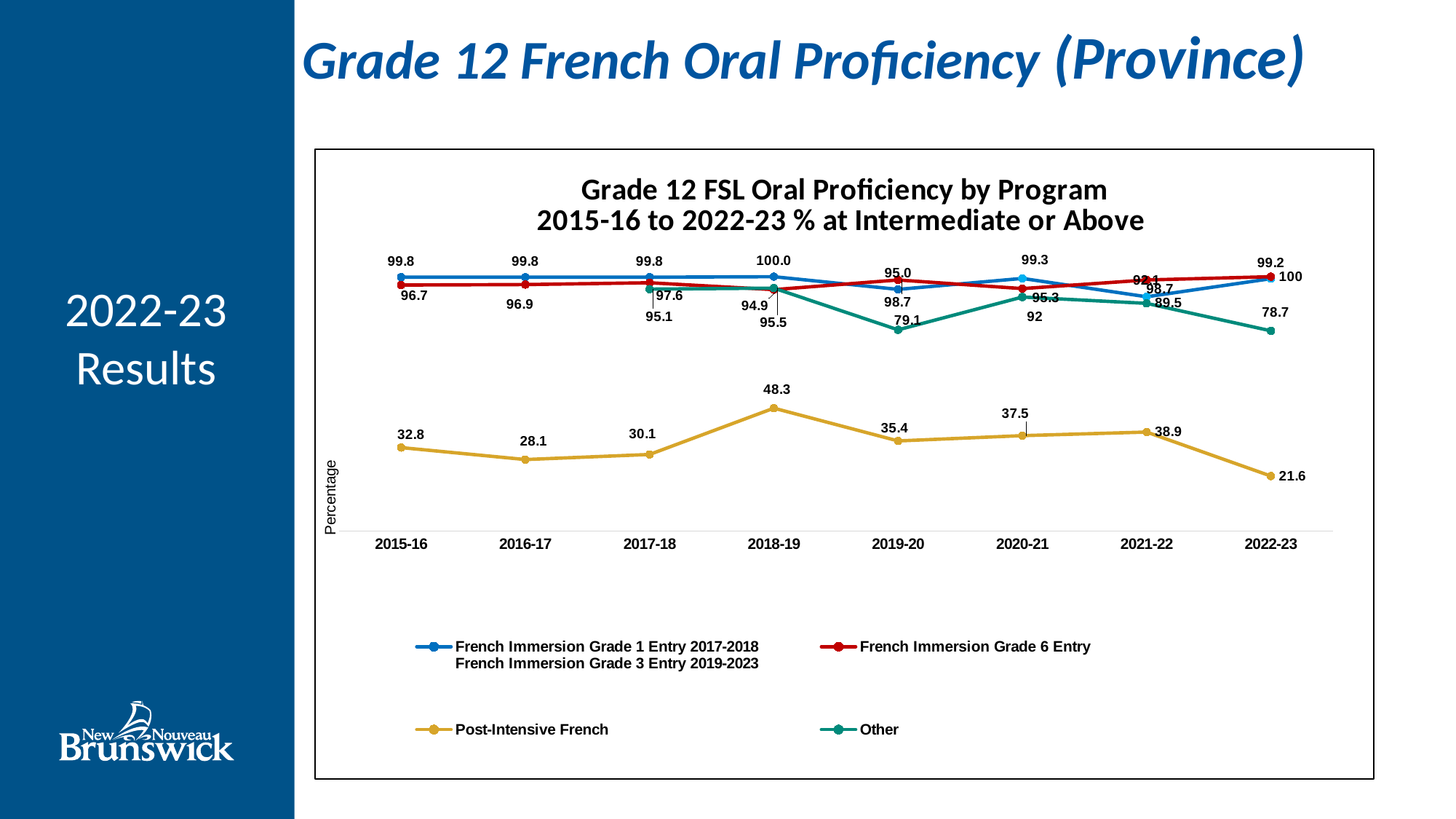
How many school years are plotted along the x axis? 8 What is the value for Post-Intensive French in 2022-23? 21.6 What is the value for Other in 2019-20? 79.1 What is the title of the chart? Grade 12 FSL Oral Proficiency by Program 2015-16 to 2022-23 % at Intermediate or Above What kind of chart is shown on the slide? Line chart What is the difference between the Post-Intensive French values in 2018-19 and 2022-23? 26.7 How many series does the legend list? 4 In which year does Post-Intensive French reach its highest value? 2018-19 Does the Post-Intensive French line rise or fall from 2021-22 to 2022-23? Fall What is the value for Post-Intensive French in 2018-19? 48.3 In which year does Post-Intensive French have its lowest value? 2022-23 Which year has the larger Post-Intensive French value, 2016-17 or 2017-18? 2017-18